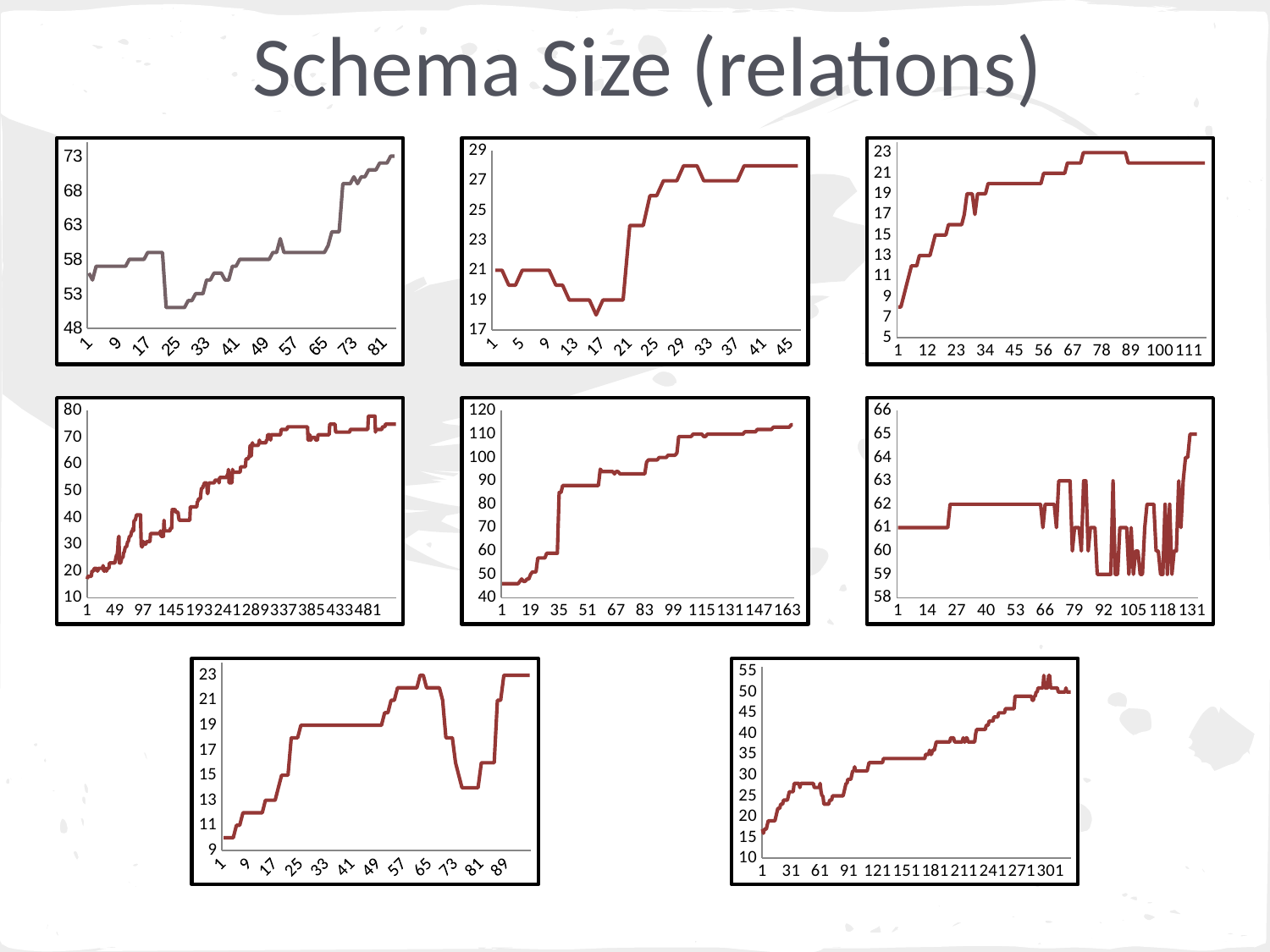
In the top-right chart, is the value at x = 1 greater or less than 9? less How many charts are shown on the slide? 8 In the middle chart of the middle row (y axis from 40 to 120), do the values generally rise or fall along the x axis? rise In the top-left chart, is the value at x = 81 greater or less than 68? greater What is the title of the slide containing the charts? Schema Size (relations) In the bottom-left chart (y axis from 9 to 23), is the value at x = 1 greater or less than 11? less What kind of chart is the top-left chart on the slide? line chart